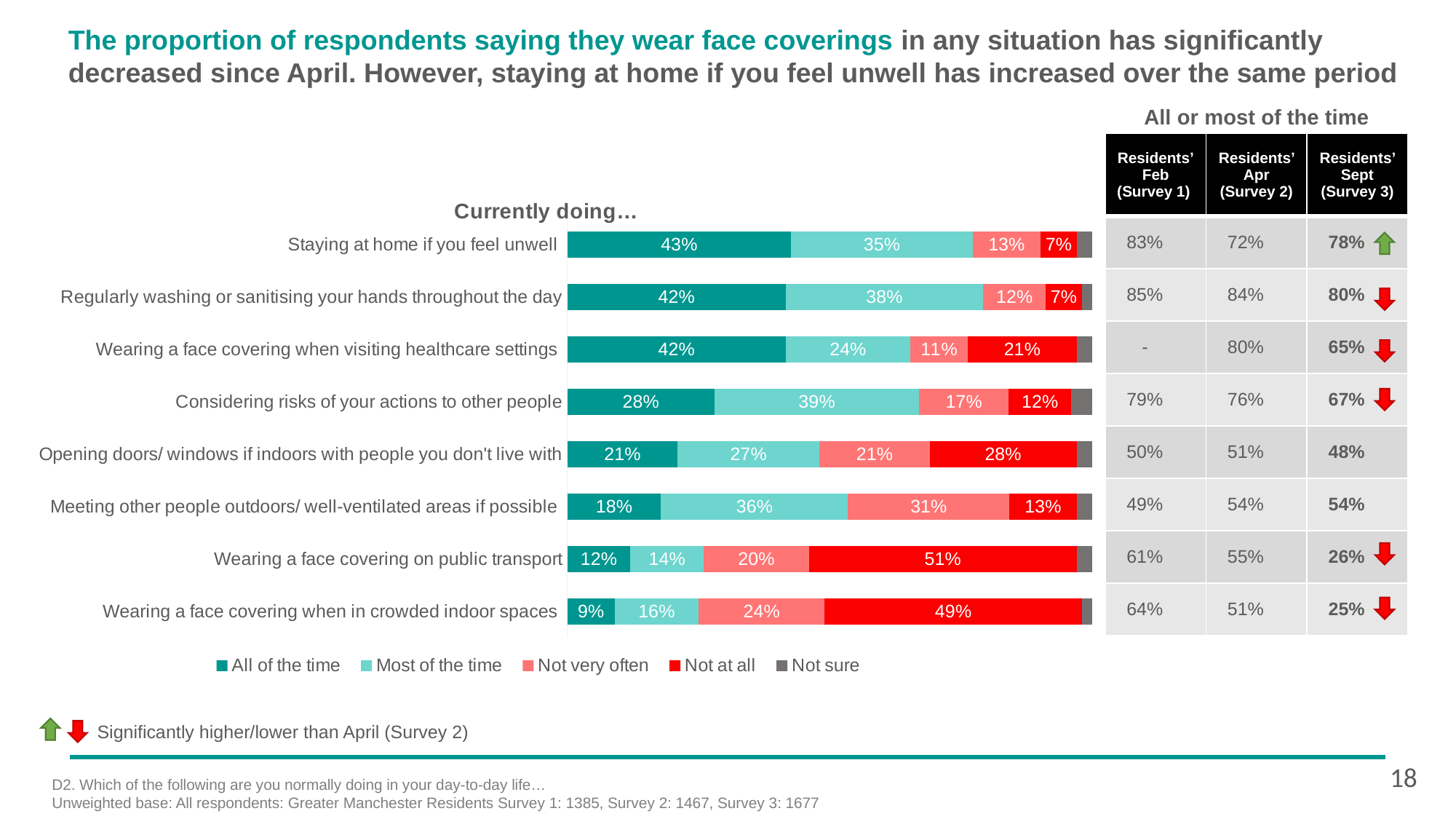
Which behaviour has the highest 'Most of the time' percentage? Considering risks of your actions to other people What is the 'Not very often' value for meeting other people outdoors/ well-ventilated areas if possible? 31% Which colour represents 'Not at all' in the chart legend? Red How many response categories does the chart legend list? 5 What percentage of respondents say they are staying at home if they feel unwell 'All of the time'? 43% What is the 'Not at all' value for wearing a face covering on public transport? 51% What type of chart is used to show the 'Currently doing…' data? Stacked bar chart What is the 'Most of the time' value for considering risks of your actions to other people? 39% How many percentage points higher is the 'Most of the time' value for regularly washing or sanitising your hands than for staying at home if you feel unwell? 3 percentage points Which has a larger 'Not at all' value: opening doors/ windows if indoors with people you don't live with, or meeting other people outdoors/ well-ventilated areas if possible? Opening doors/ windows if indoors with people you don't live with Which behaviour has the lowest 'All of the time' percentage? Wearing a face covering when in crowded indoor spaces How many behaviours are listed in the bar chart? 8